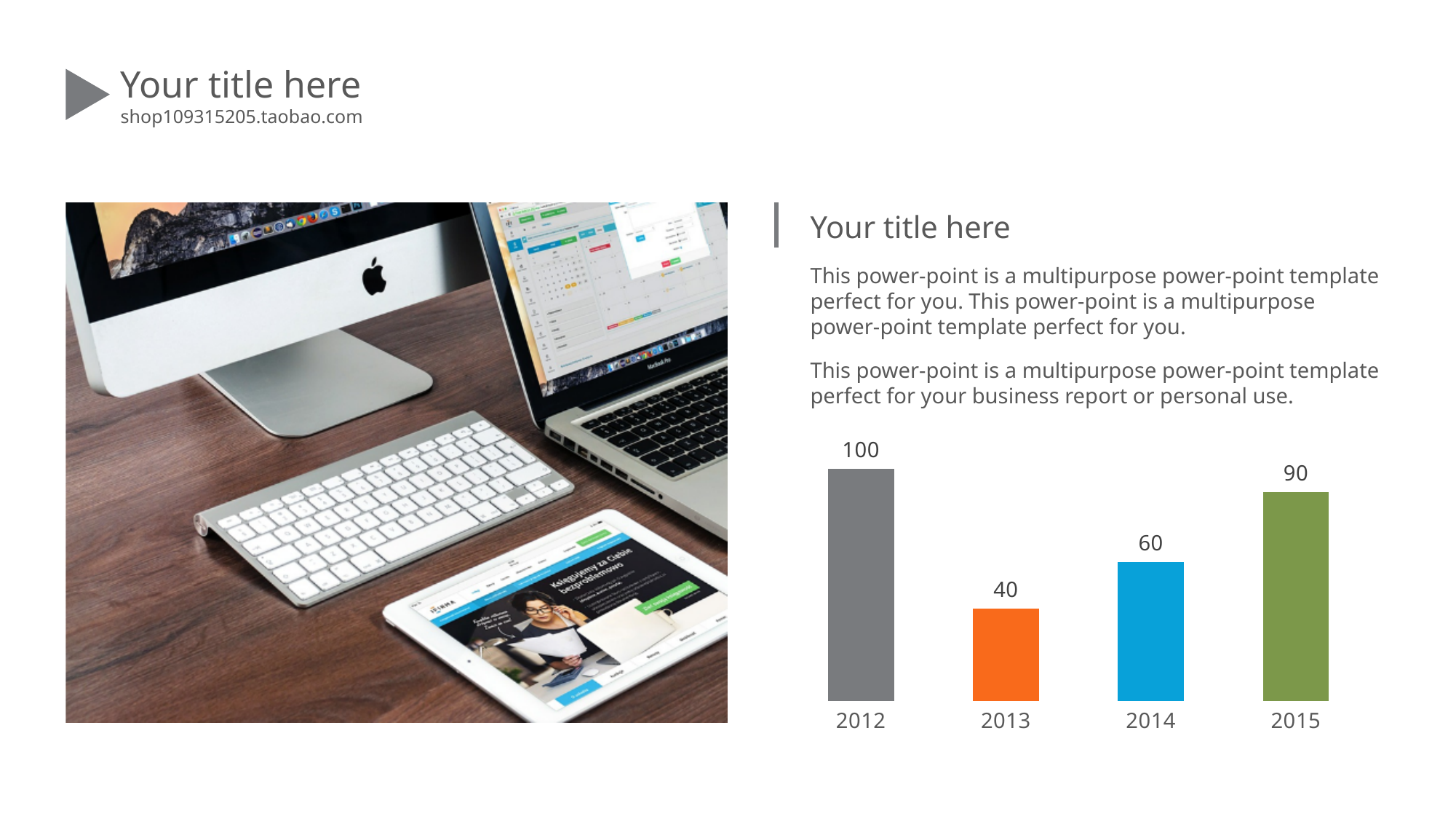
Which is larger, the value for 2014 or the value for 2015? 2015 What is the difference between the values for 2012 and 2013? 60 Which year has the highest value? 2012 Which year has the lowest value? 2013 What is the value for 2015? 90 What colour is the bar for 2013? Orange What kind of chart is shown on the slide? Bar chart What is the difference between the values for 2015 and 2014? 30 How many bars are in the chart? 4 What is the value for 2012? 100 What is the value for 2014? 60 What is the value for 2013? 40